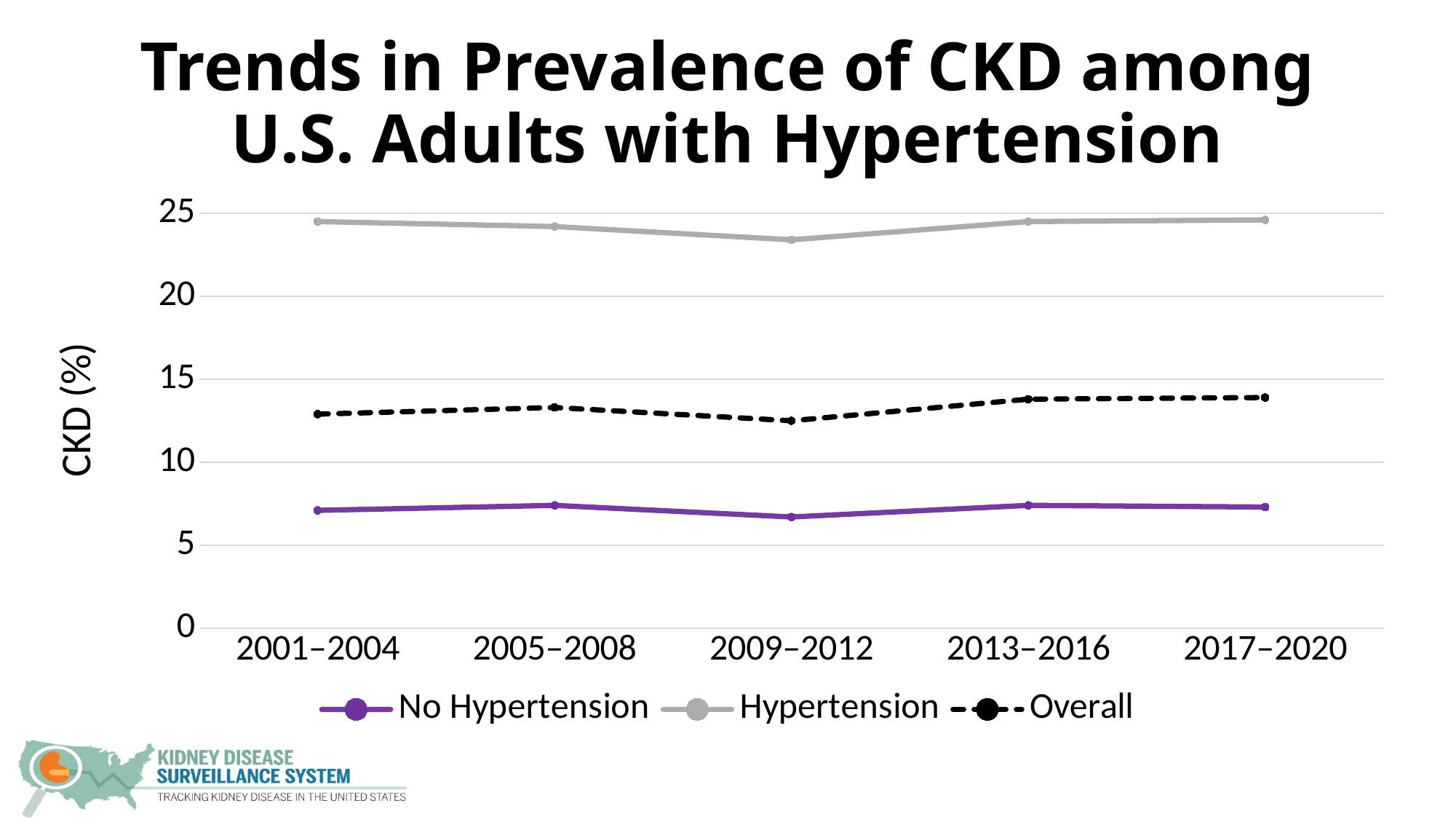
How many time periods are shown on the x axis? 5 Which series has the highest CKD prevalence across all periods? Hypertension Is the value for Overall in 2009–2012 greater or less than 10? greater What kind of chart is shown on the slide? Line chart Does the Overall series rise or fall from 2009–2012 to 2013–2016? Rise Which series has the lowest CKD prevalence across all periods? No Hypertension In which period is the Hypertension series at its lowest? 2009–2012 Is the value for No Hypertension in 2017–2020 greater or less than 10? less Is the value for Hypertension in 2009–2012 greater or less than 20? greater In 2001–2004, which is larger: the value for Hypertension or the value for No Hypertension? Hypertension How many series does the legend list? 3